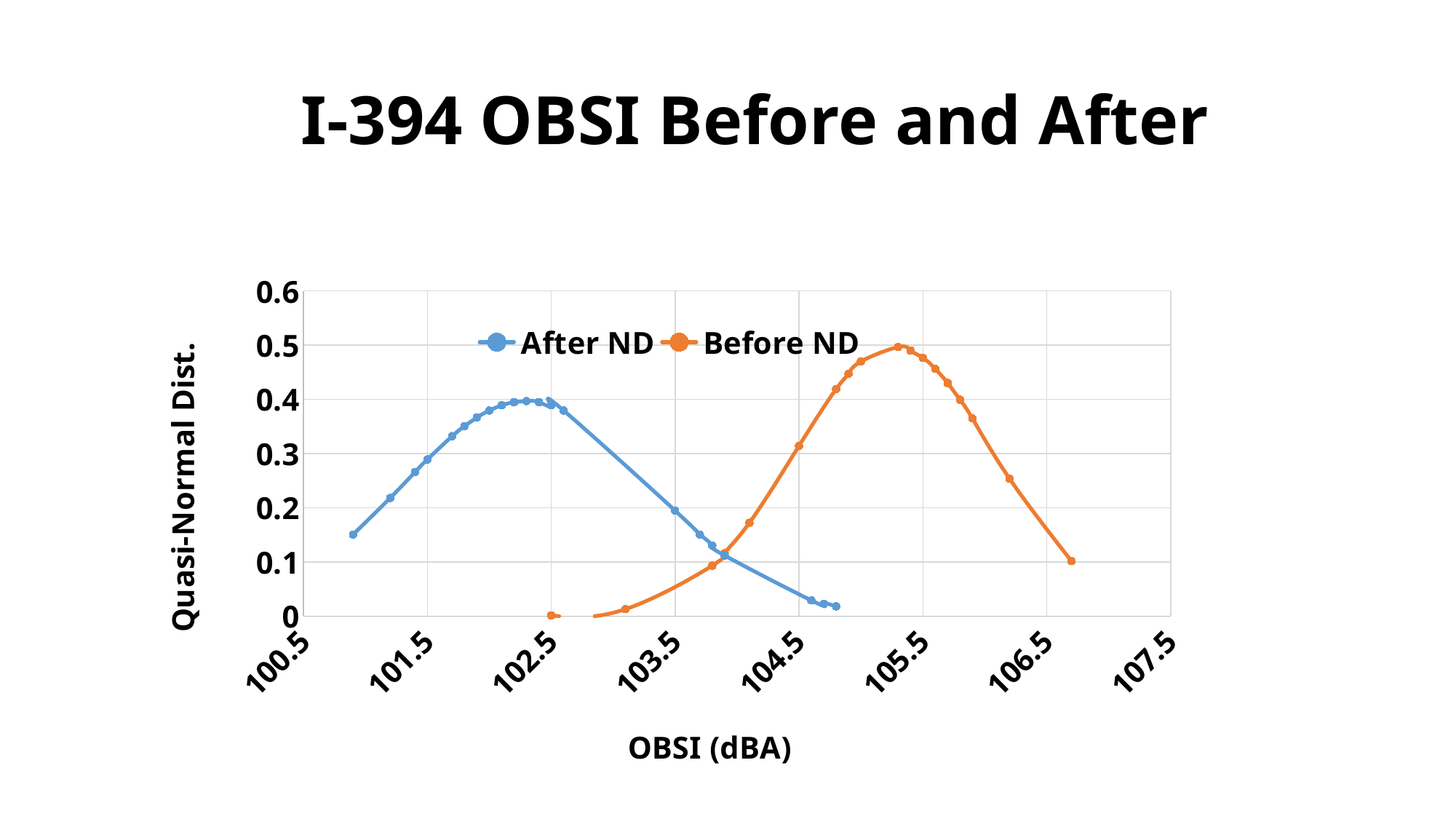
What are the two series named in the legend? After ND and Before ND Is the peak value of the After ND series greater or less than 0.5? less What is the title of the chart? I-394 OBSI Before and After Is the peak value of the After ND series greater or less than 0.3? greater Does the After ND series rise or fall as OBSI increases from 104.5 to 105? fall Which series reaches the higher peak value, After ND or Before ND? Before ND Which series has its peak at a higher OBSI (dBA) value? Before ND What is the label on the x axis? OBSI (dBA) Is the value of the Before ND series at 103.5 dBA greater or less than 0.1? less What kind of chart is shown on the slide? Line chart How many series does the legend list? 2